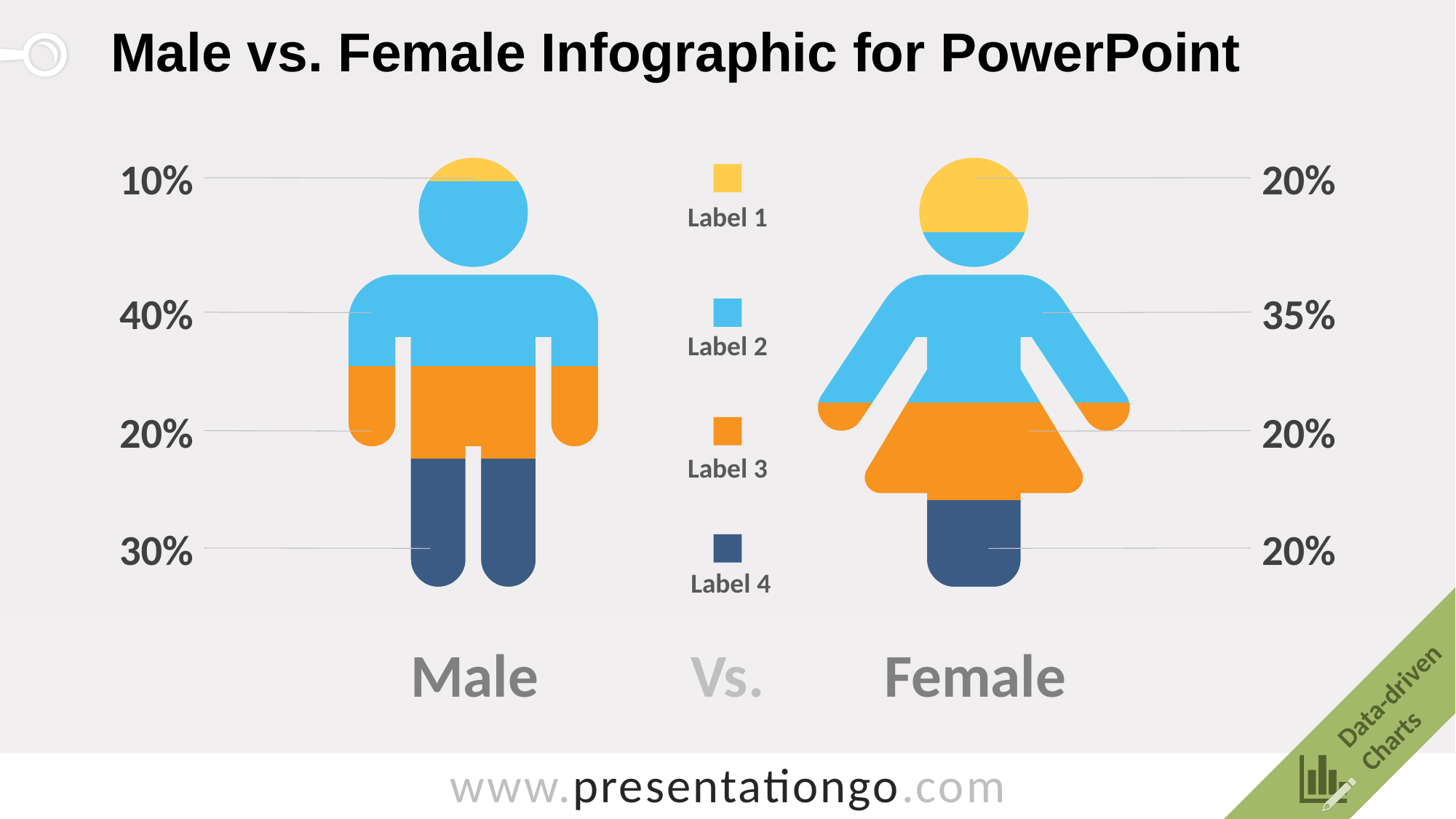
On the Female figure, what is the value for Label 4? 20% On the Female figure, what is the value for Label 2? 35% On the Male figure, which label has the lowest value? Label 1 Which is larger: the Male value for Label 4 or the Female value for Label 4? Male On the Male figure, which label has the highest value? Label 2 On the Male figure, what is the value for Label 2? 40% How many labels does the legend list? 4 On the Female figure, which label has the highest value? Label 2 On the Male figure, what is the value for Label 1? 10% What is the total of the four values shown on the Male figure? 100% Which colour represents Label 3 in the legend? Orange What is the difference between the Male and Female values for Label 2? 5%